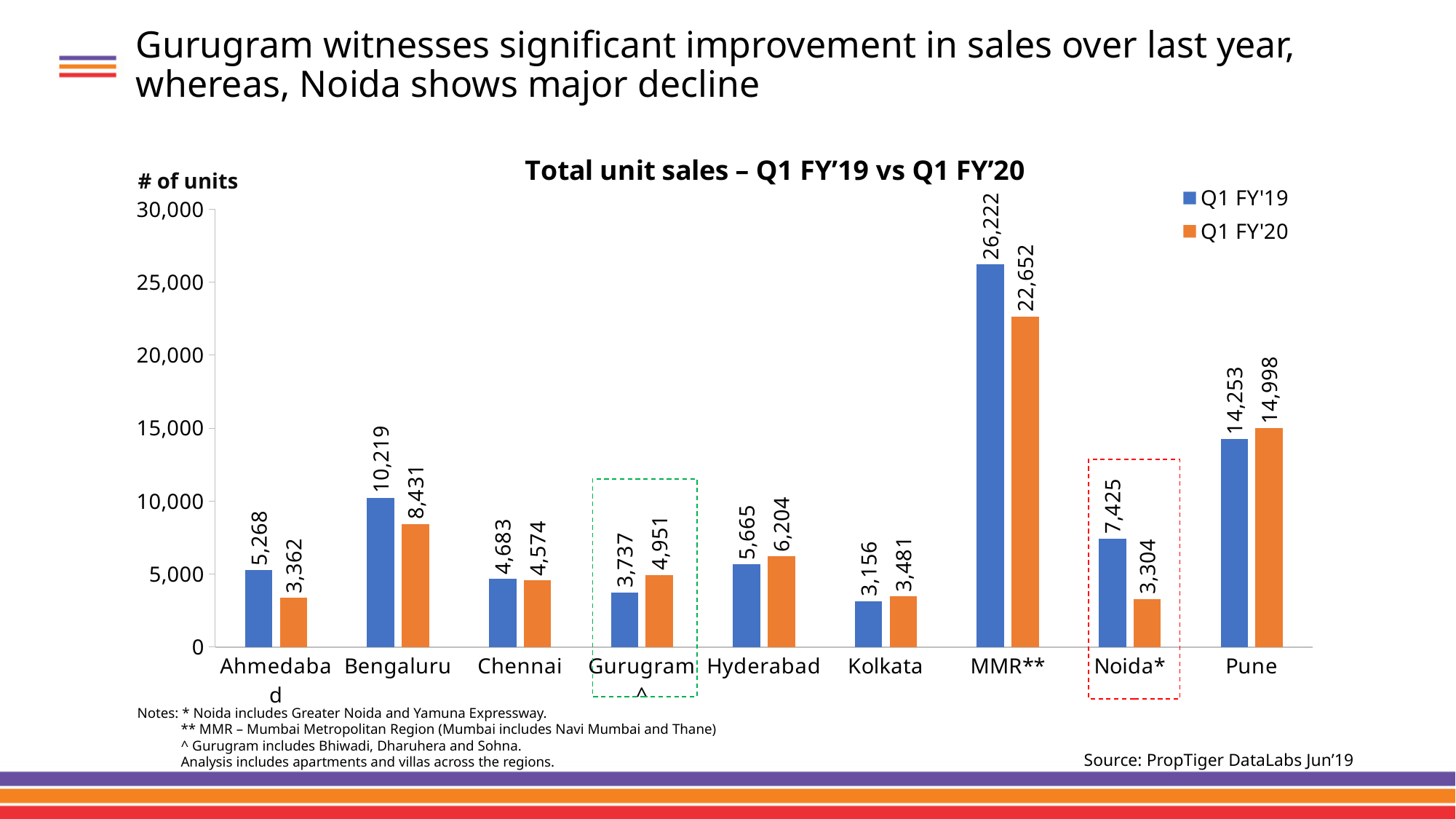
Which city has the highest Q1 FY'19 unit sales? MMR** How many cities are shown on the x axis? 9 What is the difference between the Q1 FY'19 and Q1 FY'20 values for MMR**? 3,570 What is the Q1 FY'19 value for Gurugram^? 3,737 Which city has the lowest Q1 FY'19 unit sales? Kolkata What kind of chart is shown? bar chart Is the Q1 FY'20 value for Bengaluru greater or less than 10,000? less What is the Q1 FY'20 value for Pune? 14,998 Which is larger for Hyderabad: Q1 FY'19 or Q1 FY'20? Q1 FY'20 How many series does the legend list? 2 What is the difference between the Q1 FY'19 and Q1 FY'20 values for Noida*? 4,121 What is the Q1 FY'20 value for Noida*? 3,304